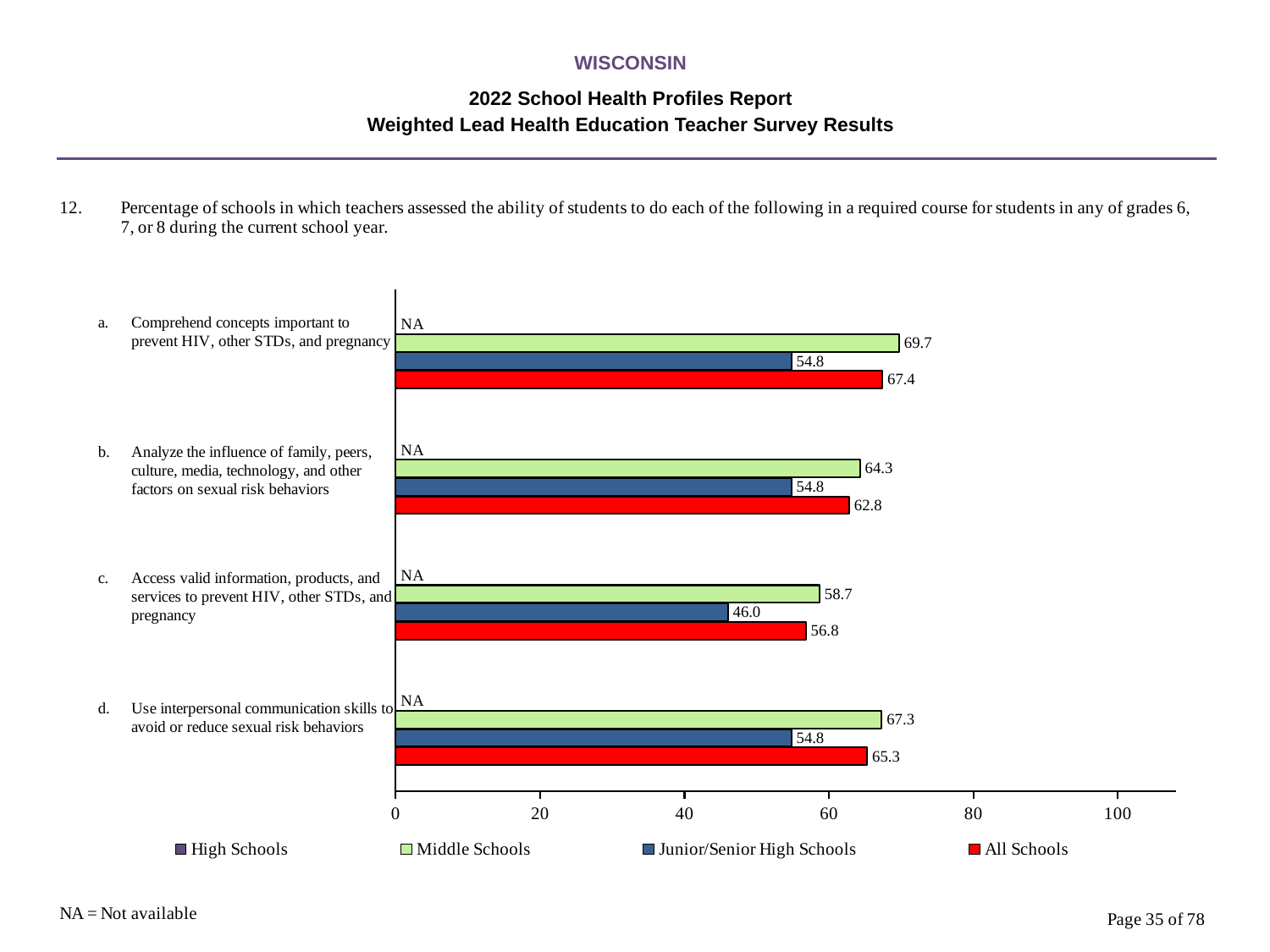
What kind of chart is shown on the slide? bar chart Is the Junior/Senior High Schools value for item c greater or less than 60? less What is shown for High Schools in item d, use interpersonal communication skills to avoid or reduce sexual risk behaviors? NA For item d, which is larger: the Middle Schools value or the Junior/Senior High Schools value? Middle Schools Which item has the highest Middle Schools value? a. Comprehend concepts important to prevent HIV, other STDs, and pregnancy What is the difference between the Middle Schools and All Schools values for item b, analyze the influence of family, peers, culture, media, technology, and other factors on sexual risk behaviors? 1.5 What is the All Schools value for item c, access valid information, products, and services to prevent HIV, other STDs, and pregnancy? 56.8 Which item has the lowest Junior/Senior High Schools value? c. Access valid information, products, and services to prevent HIV, other STDs, and pregnancy What is the Middle Schools value for item a, comprehend concepts important to prevent HIV, other STDs, and pregnancy? 69.7 How many items (categories) are plotted on the chart? 4 What is the Junior/Senior High Schools value for item c, access valid information, products, and services? 46.0 How many series does the legend list? 4